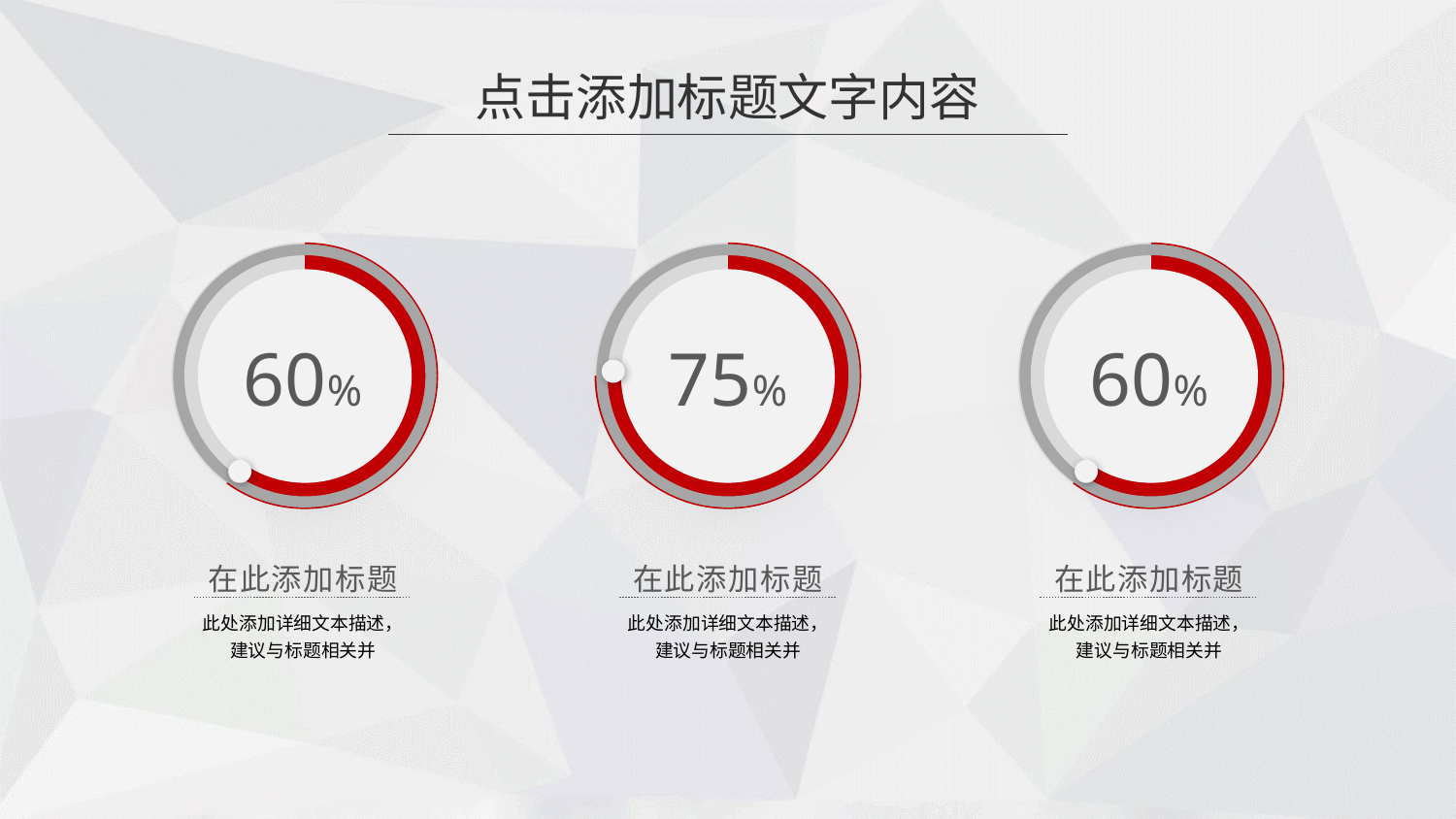
What colour is used for the filled portion of each circular chart? Red Which of the three circular charts shows the highest value? The middle chart What value is shown in the middle circular chart? 75% Is the value in the left chart greater or less than 50%? greater What value is shown in the left circular chart? 60% What kind of chart is used to display the percentages on the slide? Circular progress (doughnut) chart Is the value in the middle chart greater or less than 70%? greater How many circular progress charts are on the slide? 3 Do the left and right circular charts show the same value? Yes What is the difference between the value in the middle chart and the value in the left chart? 15% Which is larger, the value in the middle chart or the value in the right chart? The middle chart What value is shown in the right circular chart? 60%